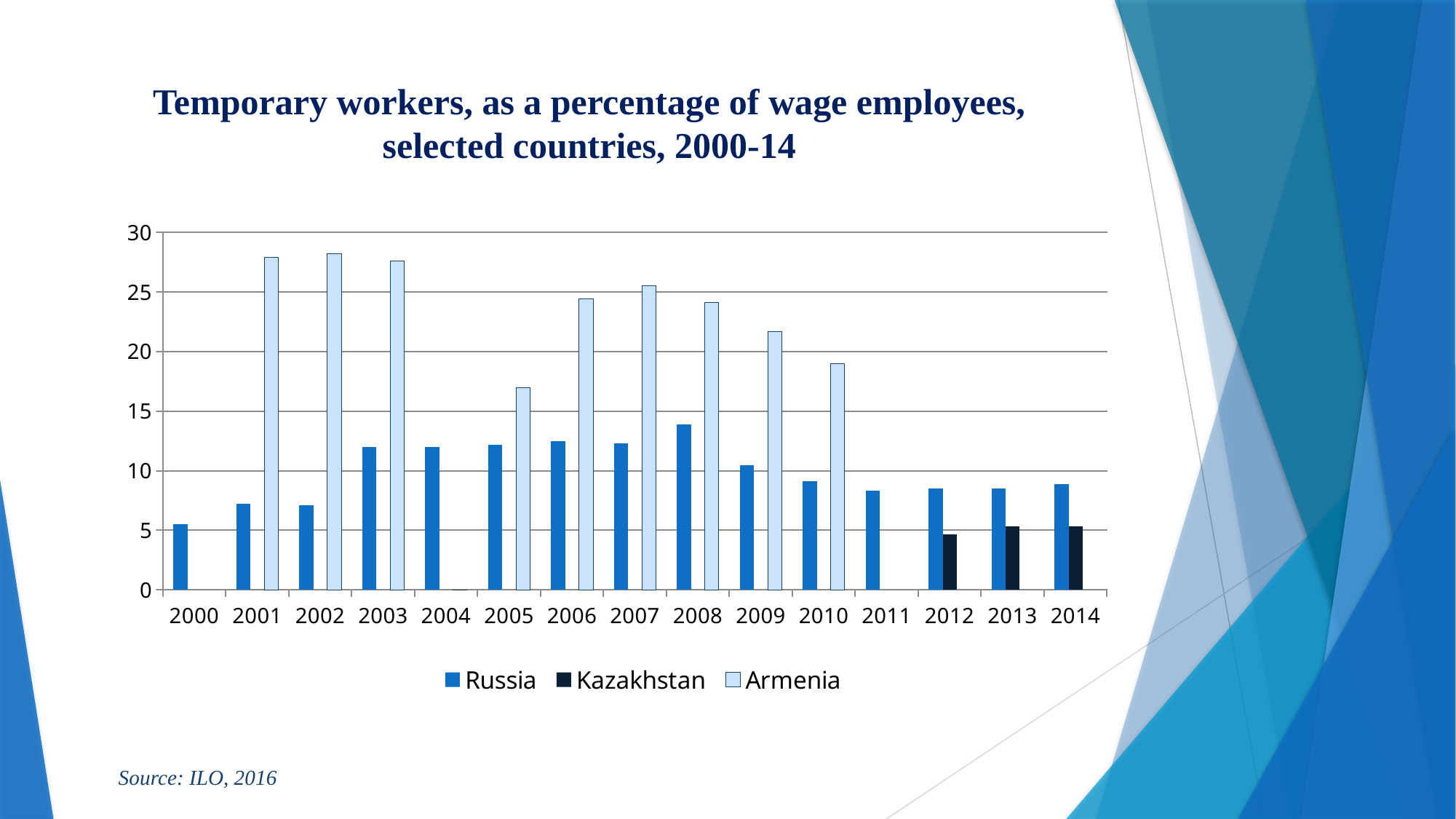
How many years are shown along the x axis? 15 Which is larger in 2012, the value for Russia or the value for Kazakhstan? Russia Is the value for Russia in 2000 greater or less than 10? less In which year is the value for Russia highest? 2008 In which year is the value for Russia lowest? 2000 Is the value for Armenia in 2005 greater or less than 20? less Do the values for Armenia rise or fall from 2007 to 2010? fall Which is larger, the value for Armenia in 2001 or the value for Armenia in 2005? Armenia in 2001 How many series does the legend list? 3 Is the value for Russia in 2008 greater or less than 10? greater What kind of chart is shown on the slide? bar chart What source is cited below the chart? ILO, 2016